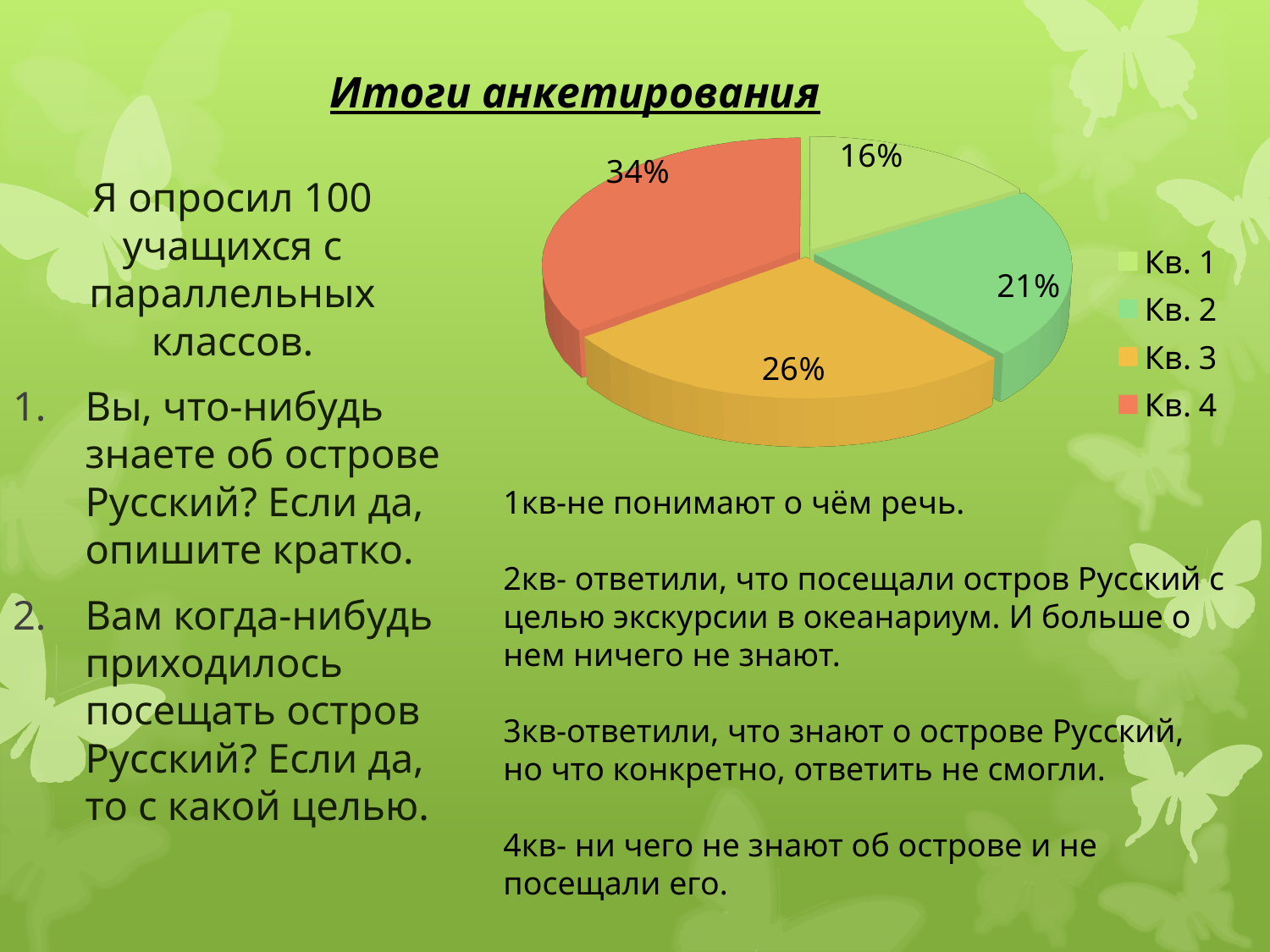
Which category has the smallest slice of the pie? Кв. 1 What percentage does the slice for Кв. 2 show? 21% How many slices does the pie chart have? 4 What is the difference in percentage points between the Кв. 4 slice and the Кв. 1 slice? 18 What percentage does the slice for Кв. 4 show? 34% What colour is the slice for Кв. 4? Red (orange-red) What percentage does the slice for Кв. 1 show? 16% Which category has the largest slice of the pie? Кв. 4 How many entries does the legend list? 4 What kind of chart is shown on the slide? Pie chart Which slice is larger, Кв. 2 or Кв. 3? Кв. 3 What percentage does the slice for Кв. 3 show? 26%